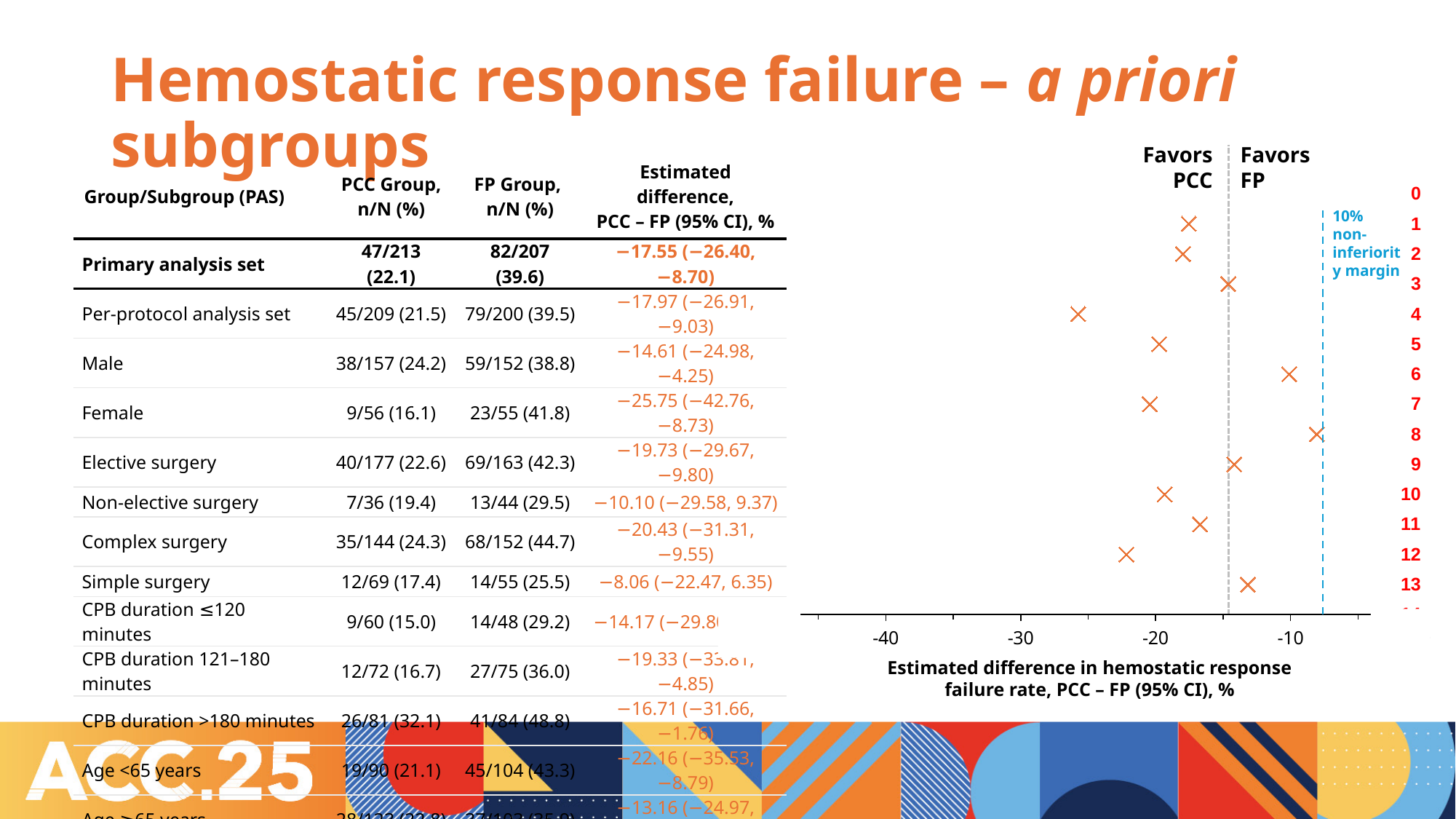
Which has the larger (less negative) value in the chart, point 6 or point 4? point 6 Is the value for point 13 in the chart greater or less than -10? less What kind of chart is shown on the right of the slide? scatter chart Which numbered point in the chart has the lowest (most negative) estimated difference? 4 What does the blue dashed vertical line in the chart represent? 10% non-inferiority margin Which has the larger (less negative) value in the chart, point 4 or point 12? point 12 Is the value for point 4 in the chart greater or less than -20? less Is the value for point 12 in the chart greater or less than -20? less Which numbered point in the chart has the highest (least negative) estimated difference? 8 What is the x-axis title of the chart? Estimated difference in hemostatic response failure rate, PCC – FP (95% CI), % How many numbered data points are plotted in the chart? 13